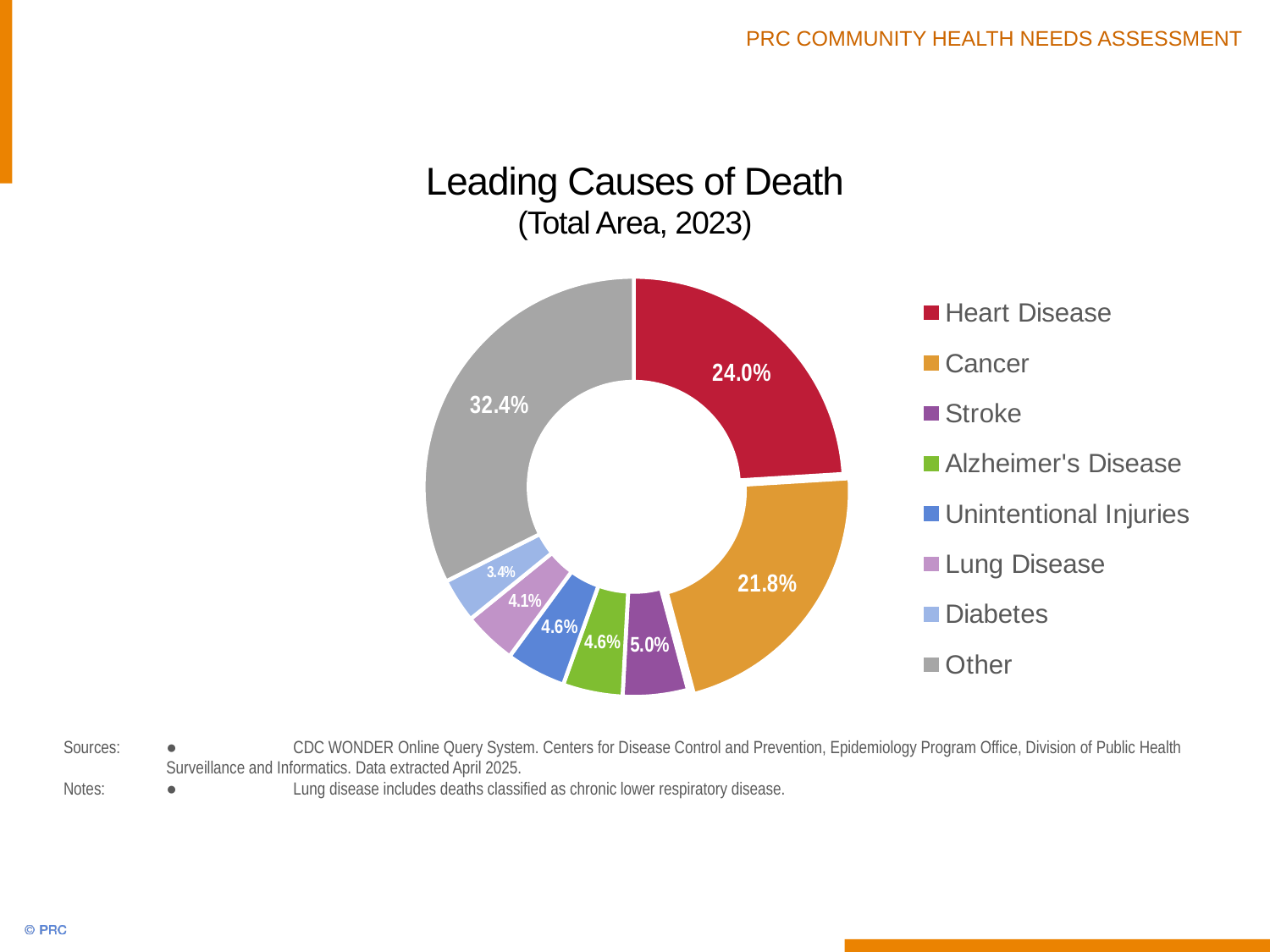
What is the title of the chart? Leading Causes of Death (Total Area, 2023) How many categories does the legend list? 8 What is the value shown for Stroke? 5.0% Which category has the smallest slice of the chart? Diabetes What percentage is shown for Diabetes? 3.4% What type of chart is shown on the slide? Doughnut chart Which is larger, the share for Stroke or the share for Lung Disease? Stroke What is the difference between the Heart Disease and Cancer percentages? 2.2% What is the value for Lung Disease? 4.1% Which category has the largest slice of the chart? Other What percentage does the Cancer slice show? 21.8% What share of deaths is attributed to Heart Disease? 24.0%